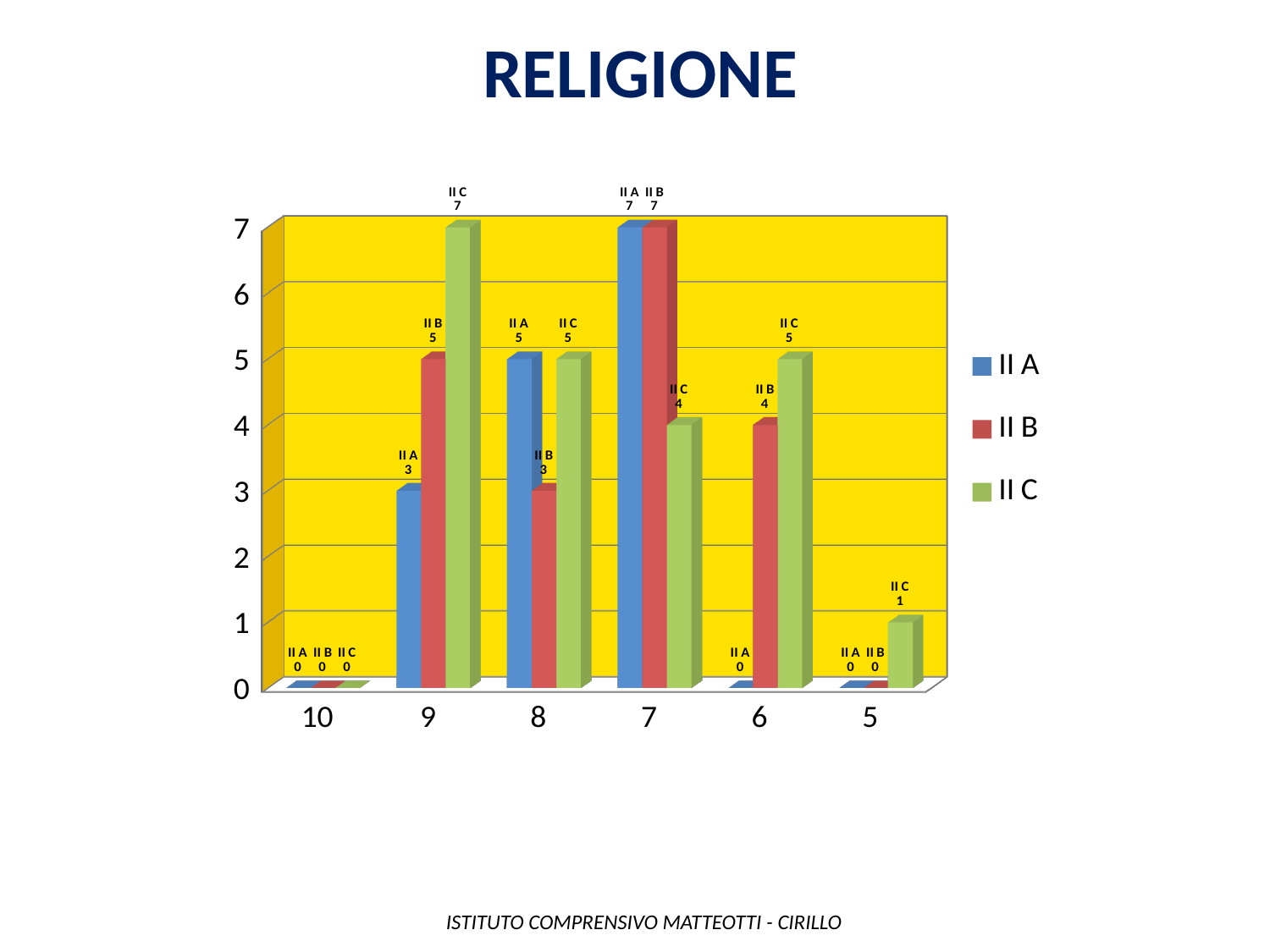
What is the value for II B at category 6? 4 What kind of chart is shown on the slide? Bar chart What is the title of the chart? RELIGIONE How many series does the legend list? 3 Which category has the lowest value for II C? 10 What is the value for II C at category 5? 1 Which category has the highest value for II A? 7 What is the value for II A at category 8? 5 What is the value for II C at category 9? 7 At category 8, which series has the larger value, II A or II B? II A What is the difference between the II C value and the II A value at category 9? 4 How many categories are shown on the x axis? 6